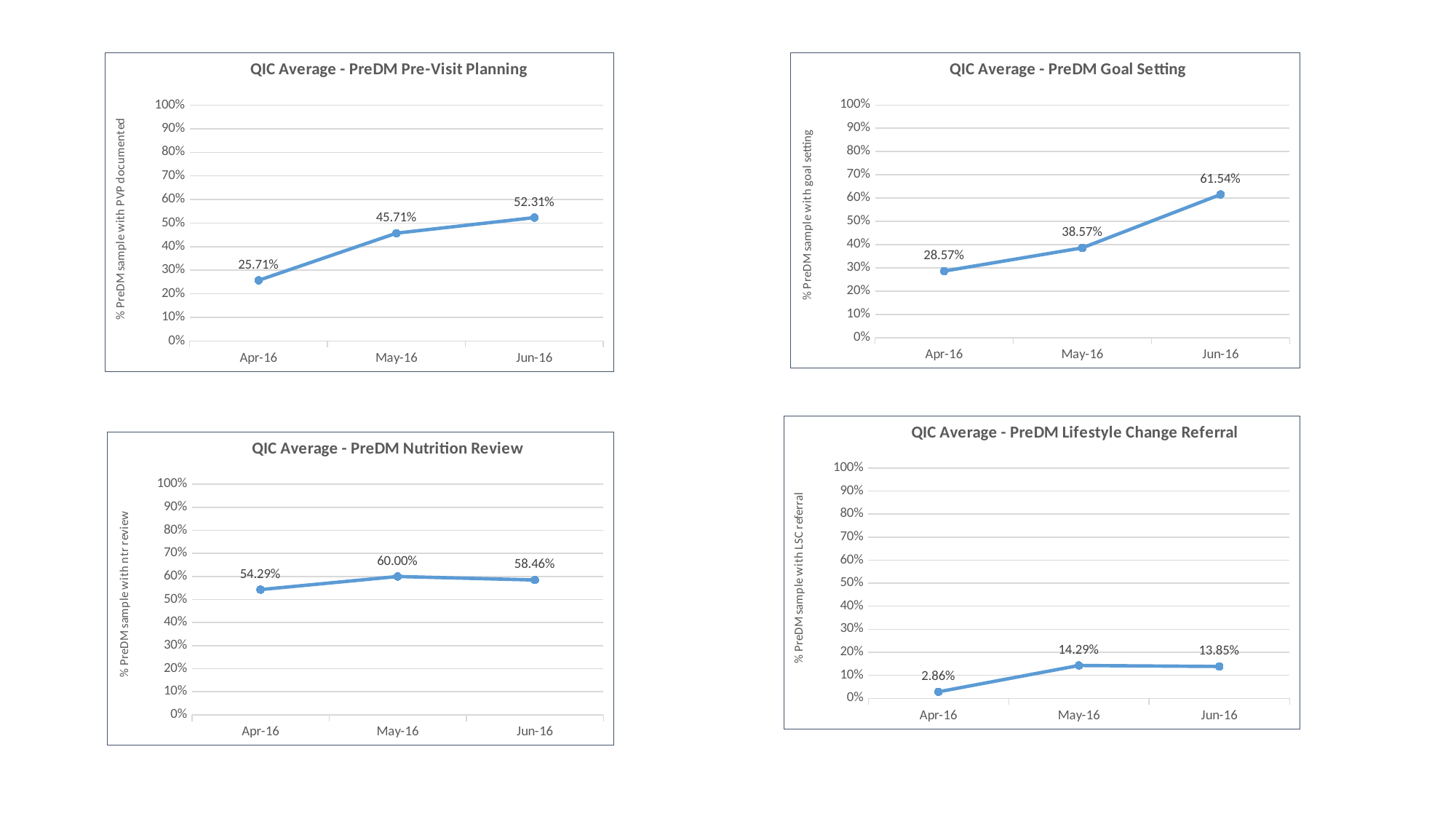
In the 'QIC Average - PreDM Lifestyle Change Referral' chart, is the value for May-16 greater or less than 20%? less In the 'QIC Average - PreDM Pre-Visit Planning' chart, what is the value for Apr-16? 25.71% In the 'QIC Average - PreDM Nutrition Review' chart, which month has the highest value? May-16 In the 'QIC Average - PreDM Lifestyle Change Referral' chart, what is the value for Apr-16? 2.86% What is the y-axis label of the 'QIC Average - PreDM Nutrition Review' chart? % PreDM sample with ntr review How many data points are plotted in the 'QIC Average - PreDM Nutrition Review' chart? 3 What kind of chart is 'QIC Average - PreDM Goal Setting'? line chart In the 'QIC Average - PreDM Pre-Visit Planning' chart, which is larger, the May-16 value or the Jun-16 value? Jun-16 In the 'QIC Average - PreDM Lifestyle Change Referral' chart, which month has the lowest value? Apr-16 In the 'QIC Average - PreDM Goal Setting' chart, what is the value for Jun-16? 61.54% In the 'QIC Average - PreDM Pre-Visit Planning' chart, do the values rise or fall from Apr-16 to Jun-16? rise In the 'QIC Average - PreDM Goal Setting' chart, what is the difference between the Jun-16 and May-16 values? 22.97%